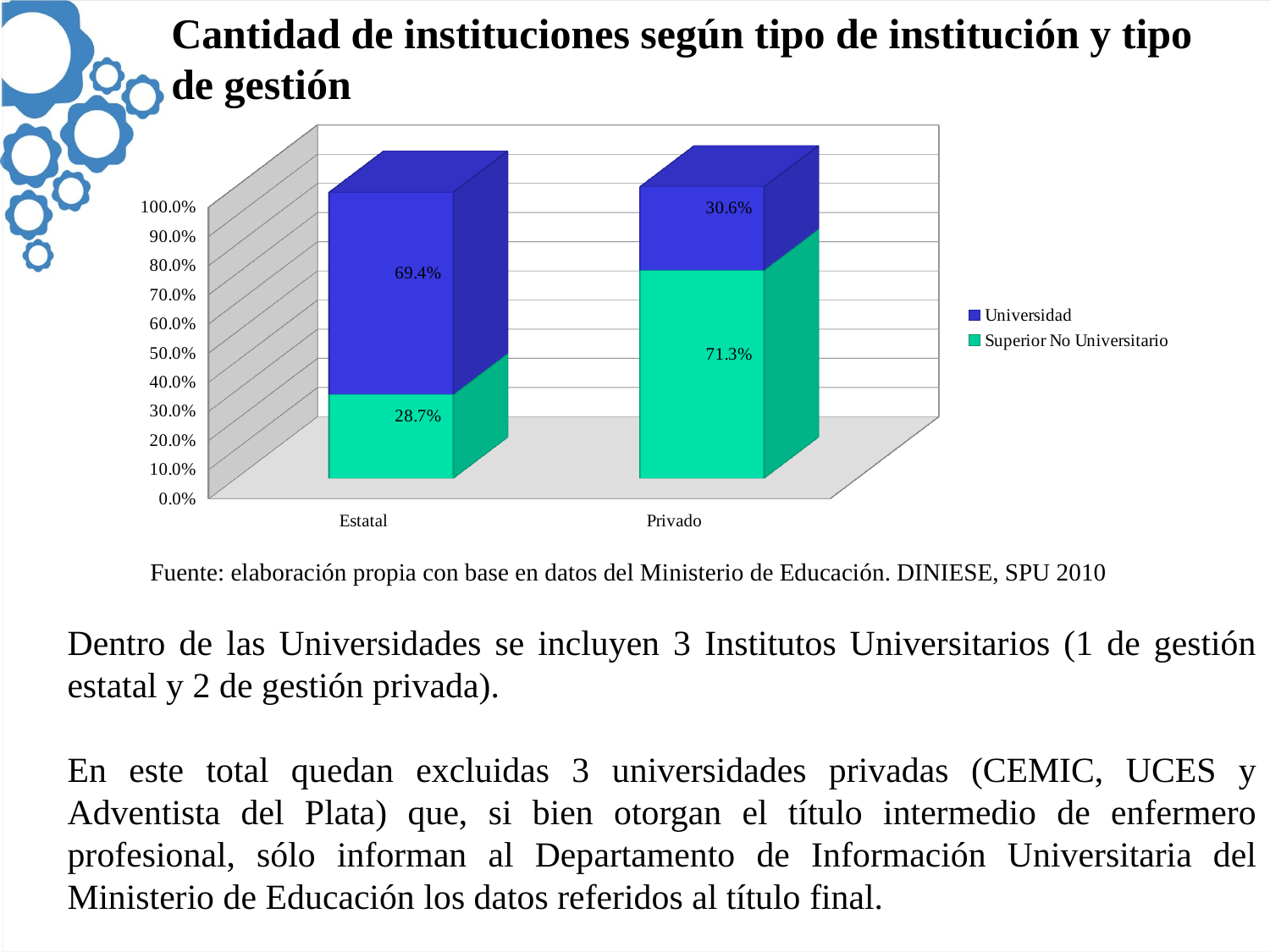
What is the value for Universidad in the Privado category? 30.6% What is the value for Superior No Universitario in the Estatal category? 28.7% How many series does the legend list? 2 How many categories are shown on the x axis? 2 In which category is the Superior No Universitario share higher, Estatal or Privado? Privado What kind of chart is shown on the slide? Stacked bar chart Which series is shown in blue in the legend? Universidad What is the value for Universidad in the Estatal category? 69.4% In which category is the Universidad share higher, Estatal or Privado? Estatal What is the difference between the Universidad and Superior No Universitario values in the Estatal category? 40.7 percentage points What is the difference between the Universidad values for Estatal and Privado? 38.8 percentage points What is the value for Superior No Universitario in the Privado category? 71.3%